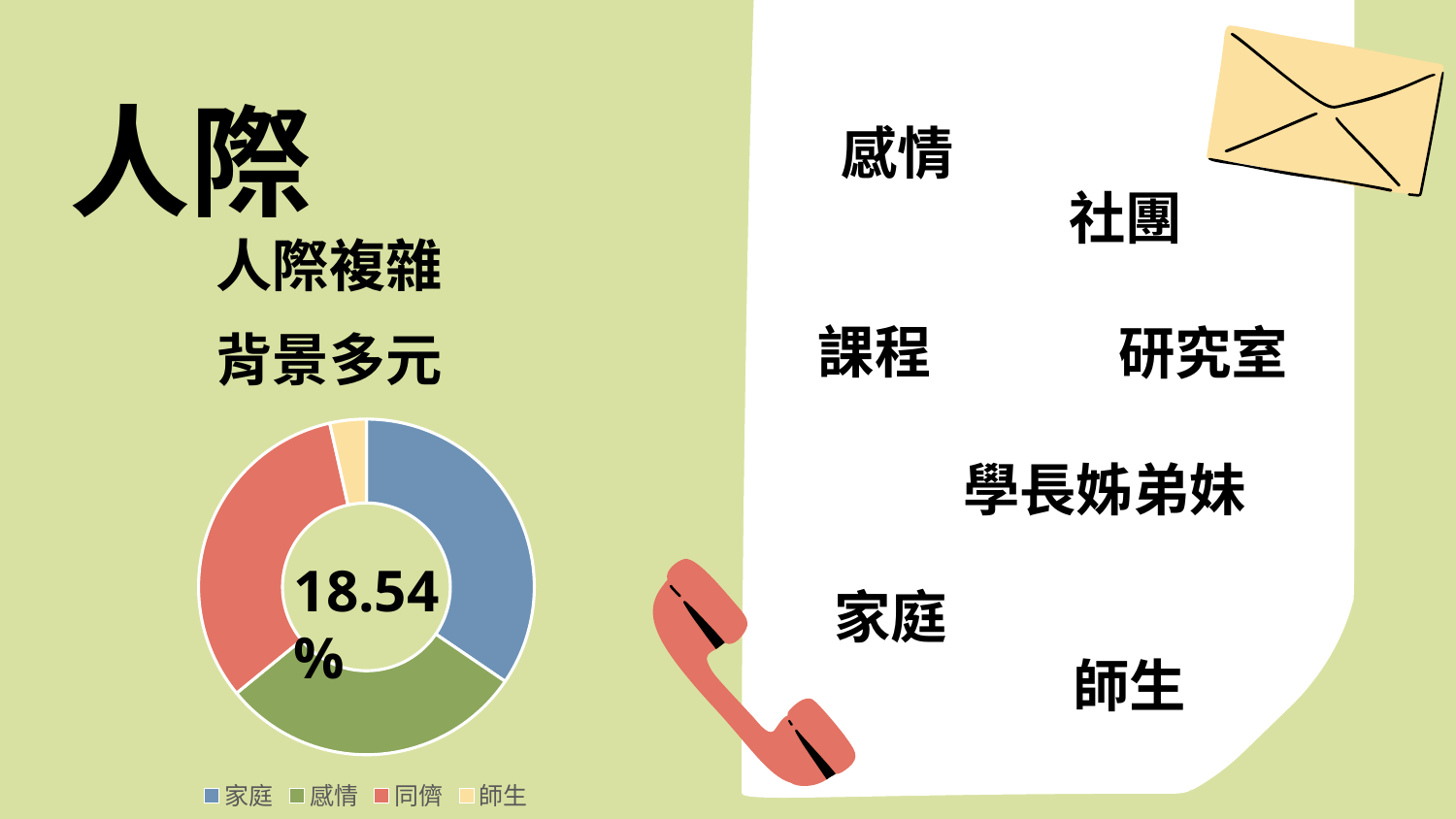
What value is printed in the centre of the doughnut chart? 18.54% Which category has the smallest slice in the doughnut chart? 師生 Which category has the largest slice in the doughnut chart? 家庭 Which slice is larger in the doughnut chart, 同儕 or 師生? 同儕 How many entries does the legend of the doughnut chart list? 4 What colour represents 同儕 in the doughnut chart? red Which slice is larger in the doughnut chart, 家庭 or 師生? 家庭 What kind of chart is shown on the slide? doughnut chart How many categories does the doughnut chart show? 4 Which slice is larger in the doughnut chart, 感情 or 師生? 感情